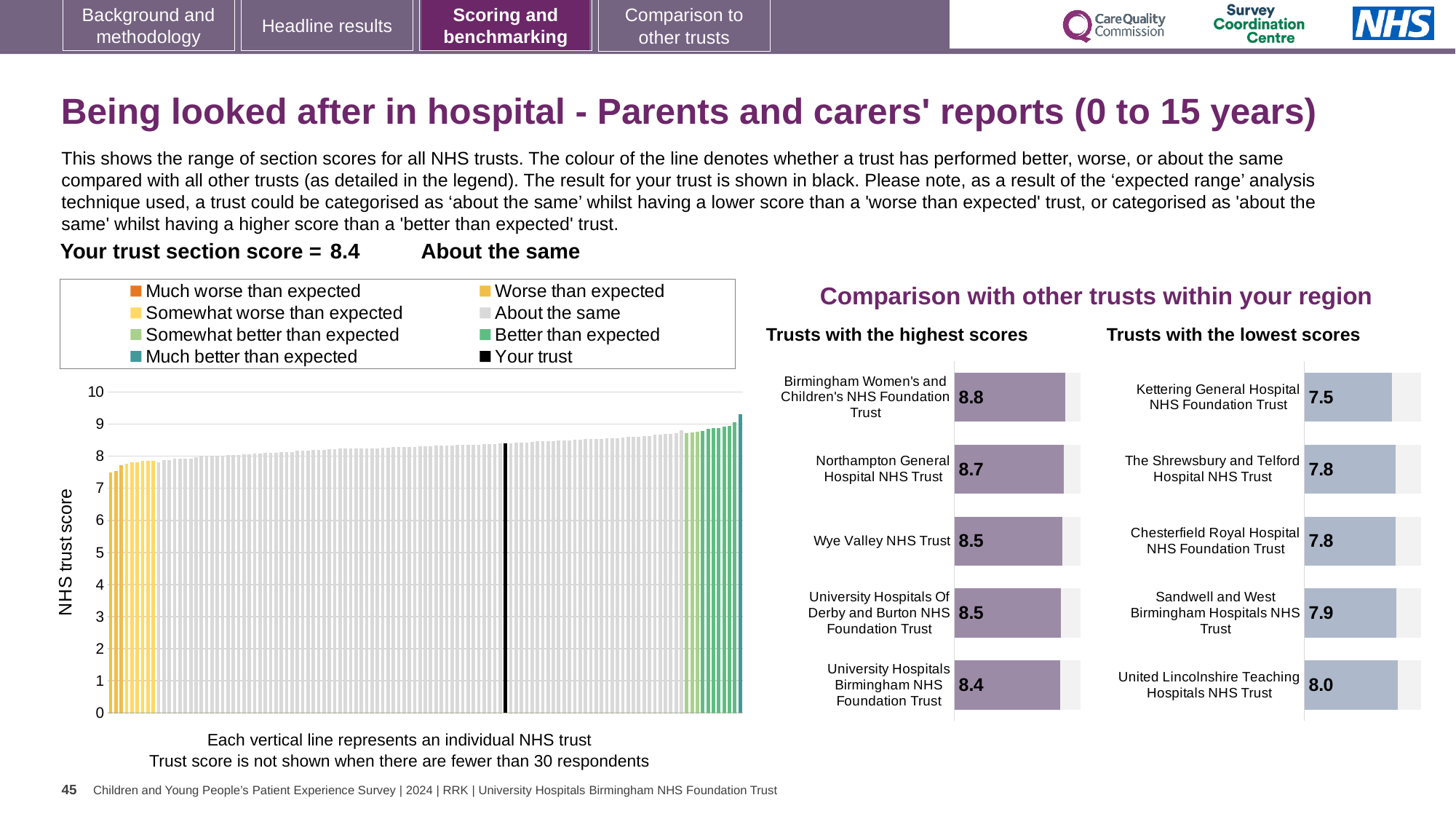
In the 'Trusts with the lowest scores' chart, which trust has the lowest score? Kettering General Hospital NHS Foundation Trust In the 'Trusts with the lowest scores' chart, what is the score for Kettering General Hospital NHS Foundation Trust? 7.5 What type of chart is the large chart on the left showing all NHS trusts? Bar chart In the 'Trusts with the lowest scores' chart, what is the score for United Lincolnshire Teaching Hospitals NHS Trust? 8.0 In the 'Trusts with the highest scores' chart, what is the difference between the scores of Birmingham Women's and Children's NHS Foundation Trust and University Hospitals Birmingham NHS Foundation Trust? 0.4 In the 'Trusts with the highest scores' chart, which trust has the highest score? Birmingham Women's and Children's NHS Foundation Trust How many trusts are listed in the 'Trusts with the lowest scores' chart? 5 In the large chart on the left, is the value for the highest-scoring trust greater or less than 10? less In the 'Trusts with the lowest scores' chart, which has the larger score: Sandwell and West Birmingham Hospitals NHS Trust or Kettering General Hospital NHS Foundation Trust? Sandwell and West Birmingham Hospitals NHS Trust In the 'Trusts with the highest scores' chart, what is the score for Wye Valley NHS Trust? 8.5 How many entries does the legend of the large chart on the left list? 8 In the 'Trusts with the highest scores' chart, what is the score for Birmingham Women's and Children's NHS Foundation Trust? 8.8